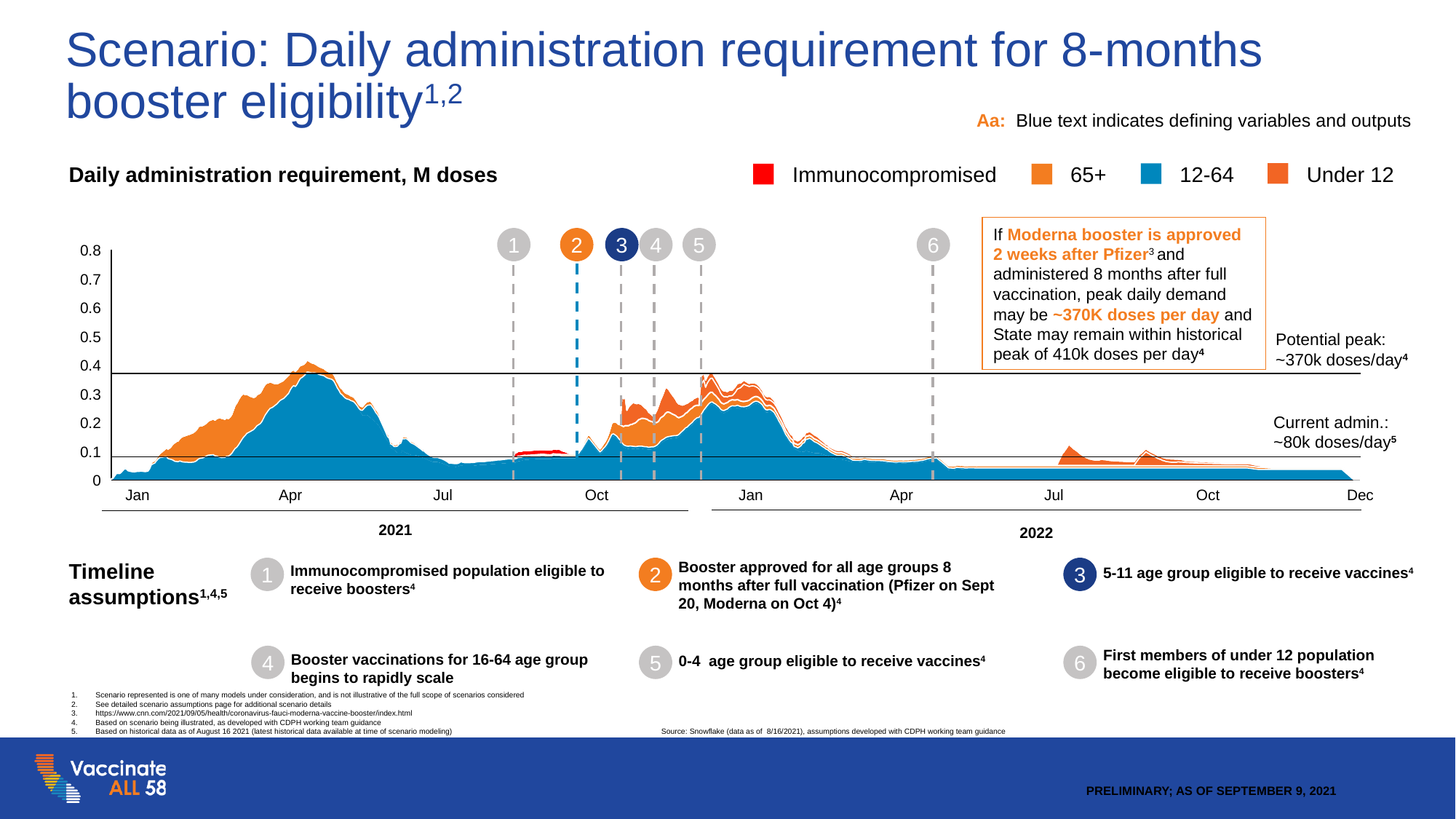
What is the highest value shown on the chart's y axis? 0.8 What is the title of the chart? Daily administration requirement, M doses Is the total daily administration requirement around December 2022 greater or less than 0.1? less Is the total daily administration requirement at its peak around January 2022 greater or less than 0.3? greater Does the total daily administration requirement rise or fall between the April 2021 peak and July 2021? Fall Is the total daily administration requirement at its peak around April 2021 greater or less than 0.3? greater How many series does the chart legend list? 4 Which is larger: the total daily administration requirement around January 2022 or around July 2022? January 2022 Which colour represents the 12-64 series in the chart? Blue How many numbered timeline markers are placed on the chart? 6 What kind of chart is shown on the slide? Area chart